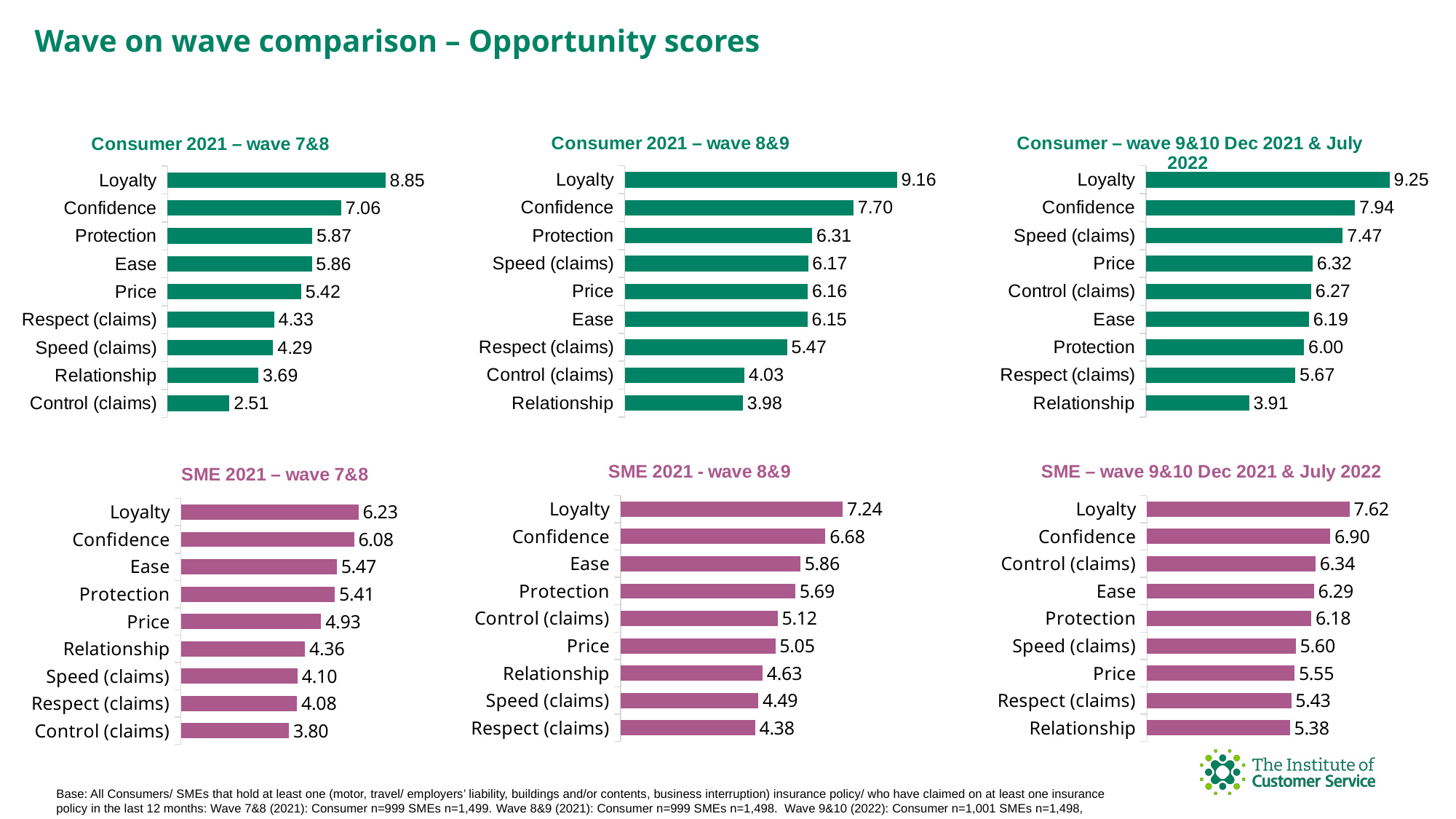
In the 'SME – wave 9&10 Dec 2021 & July 2022' chart, what is the value for Relationship? 5.38 In the 'Consumer 2021 – wave 7&8' chart, what is the value for Control (claims)? 2.51 In the 'Consumer 2021 – wave 7&8' chart, what is the value for Protection? 5.87 How many categories are shown in the 'Consumer 2021 – wave 7&8' chart? 9 In the 'SME – wave 9&10 Dec 2021 & July 2022' chart, which is larger, Control (claims) or Ease? Control (claims) In the 'SME 2021 - wave 8&9' chart, what is the difference between Loyalty and Confidence? 0.56 In the 'SME 2021 – wave 7&8' chart, which category has the highest value? Loyalty What kind of chart is the 'SME 2021 – wave 7&8' chart? Bar chart In the 'Consumer – wave 9&10 Dec 2021 & July 2022' chart, what is the difference between Loyalty and Relationship? 5.34 How many charts are shown on the slide? 6 In the 'Consumer 2021 – wave 8&9' chart, which category has the lowest value? Relationship In the 'Consumer – wave 9&10 Dec 2021 & July 2022' chart, what is the value for Speed (claims)? 7.47